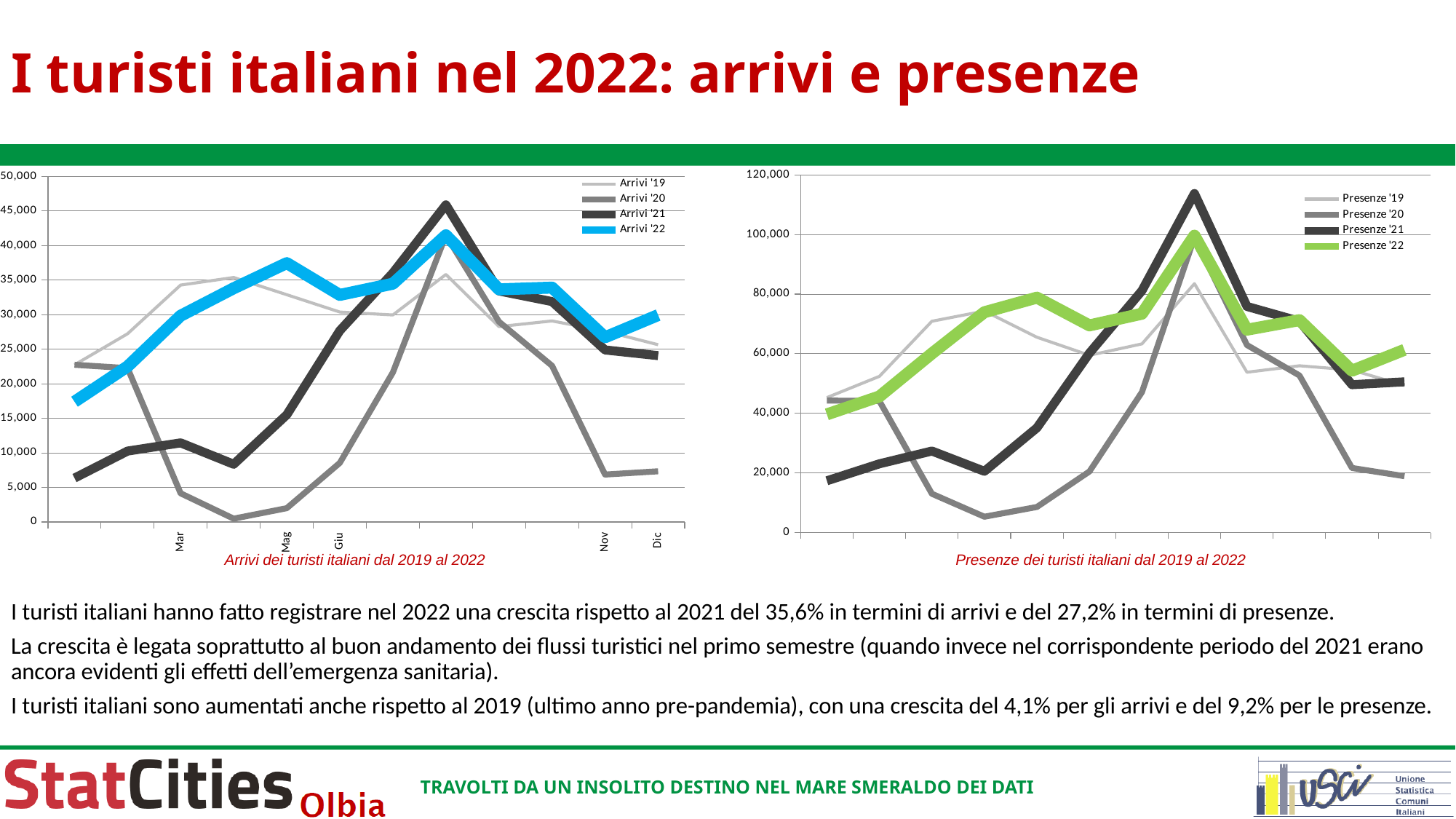
In the right chart 'Presenze dei turisti italiani dal 2019 al 2022', is the peak value of Presenze '21 greater or less than 100,000? greater In the left chart 'Arrivi dei turisti italiani dal 2019 al 2022', does Arrivi '22 rise or fall from Mar to Mag? rise In the left chart 'Arrivi dei turisti italiani dal 2019 al 2022', is the value of Arrivi '22 in Giu greater or less than 30,000? greater In the left chart 'Arrivi dei turisti italiani dal 2019 al 2022', is the value of Arrivi '21 in Mar greater or less than 10,000? greater What colour is the Presenze '22 line in the right chart 'Presenze dei turisti italiani dal 2019 al 2022'? Green In the left chart 'Arrivi dei turisti italiani dal 2019 al 2022', which series reaches the highest peak? Arrivi '21 How many series does the legend of the right chart, 'Presenze dei turisti italiani dal 2019 al 2022', list? 4 In the right chart 'Presenze dei turisti italiani dal 2019 al 2022', which series reaches the highest peak? Presenze '21 In the left chart 'Arrivi dei turisti italiani dal 2019 al 2022', which is larger: the peak of Arrivi '21 or the peak of Arrivi '22? Arrivi '21 What kind of chart is the left chart, 'Arrivi dei turisti italiani dal 2019 al 2022'? Line chart